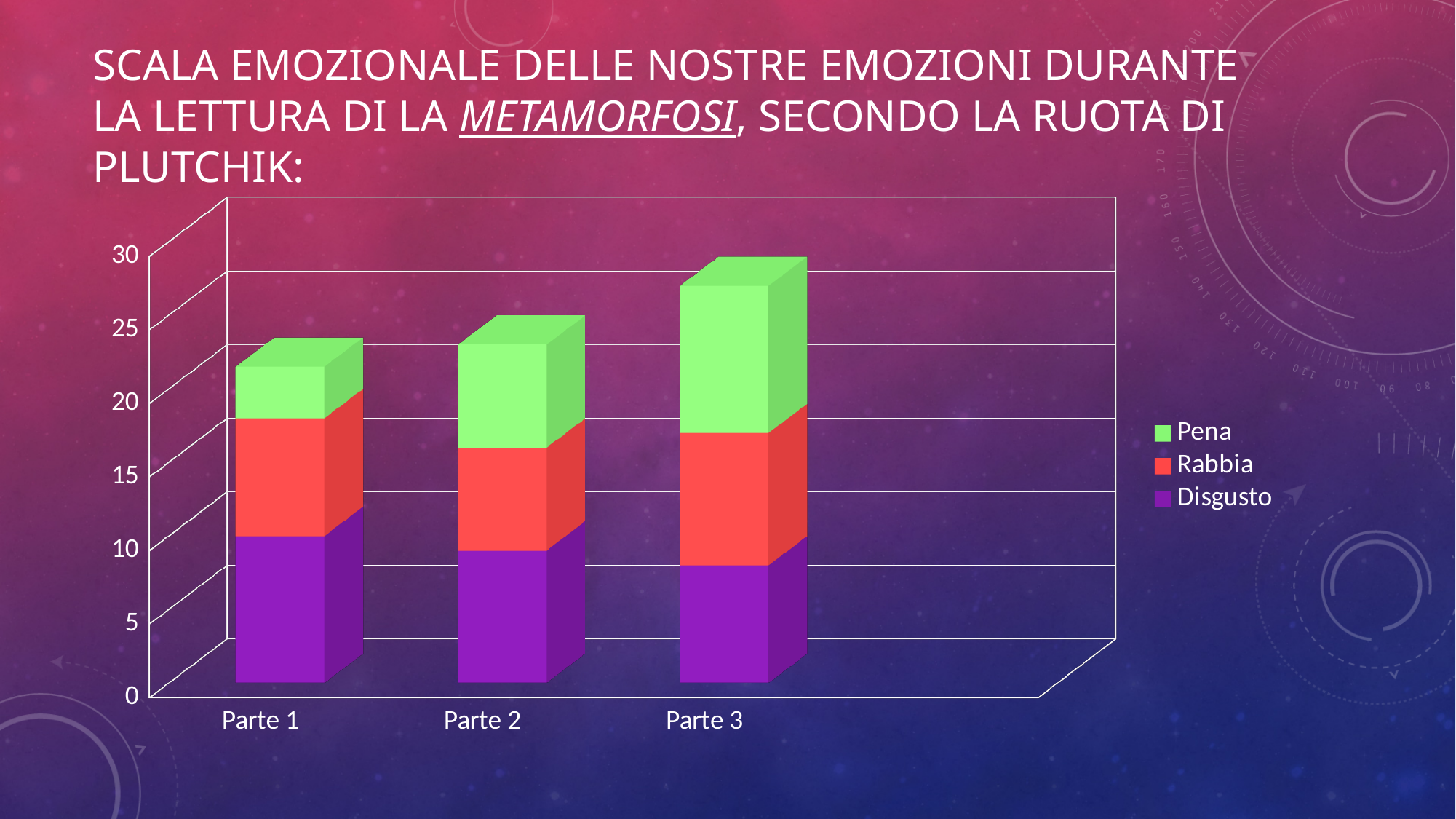
Which category has the tallest stacked bar overall? Parte 3 What kind of chart is shown on the slide? stacked bar chart How many series does the chart legend list? 3 Is the total stacked value for Parte 3 greater or less than 25? greater Which series is shown in green in the chart legend? Pena Which category has the shortest stacked bar overall? Parte 1 Is the total stacked value for Parte 2 greater or less than 20? greater Which is larger, the Pena segment for Parte 3 or the Pena segment for Parte 1? Parte 3 Is the total stacked value for Parte 1 greater or less than 25? less Which series is shown in purple in the chart legend? Disgusto Do the total stacked values rise or fall from Parte 1 to Parte 3? rise How many categories are shown on the x axis of the chart? 3